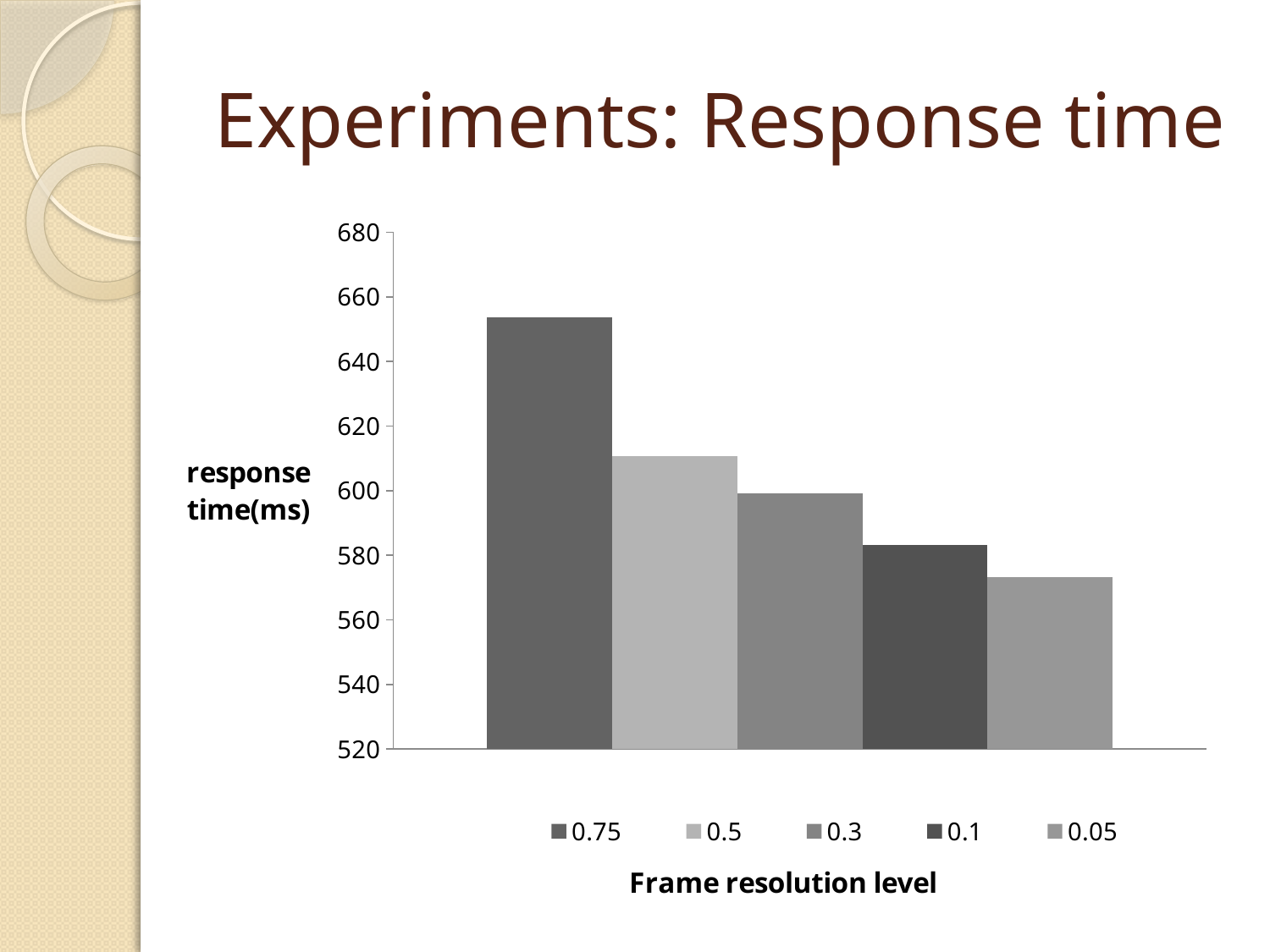
Do the response times rise or fall as the frame resolution level goes from 0.75 to 0.05 along the x axis? fall What is the label on the vertical axis of the chart? response time(ms) How many entries does the legend list? 5 What kind of chart is shown on the slide? bar chart Is the response time for frame resolution level 0.5 greater or less than 600? greater Which has a larger response time, frame resolution level 0.5 or 0.1? 0.5 Is the response time for frame resolution level 0.75 greater or less than 640? greater Is the response time for frame resolution level 0.05 greater or less than 580? less Which frame resolution level has the highest response time? 0.75 How many bars are plotted in the chart? 5 Which frame resolution level has the lowest response time? 0.05